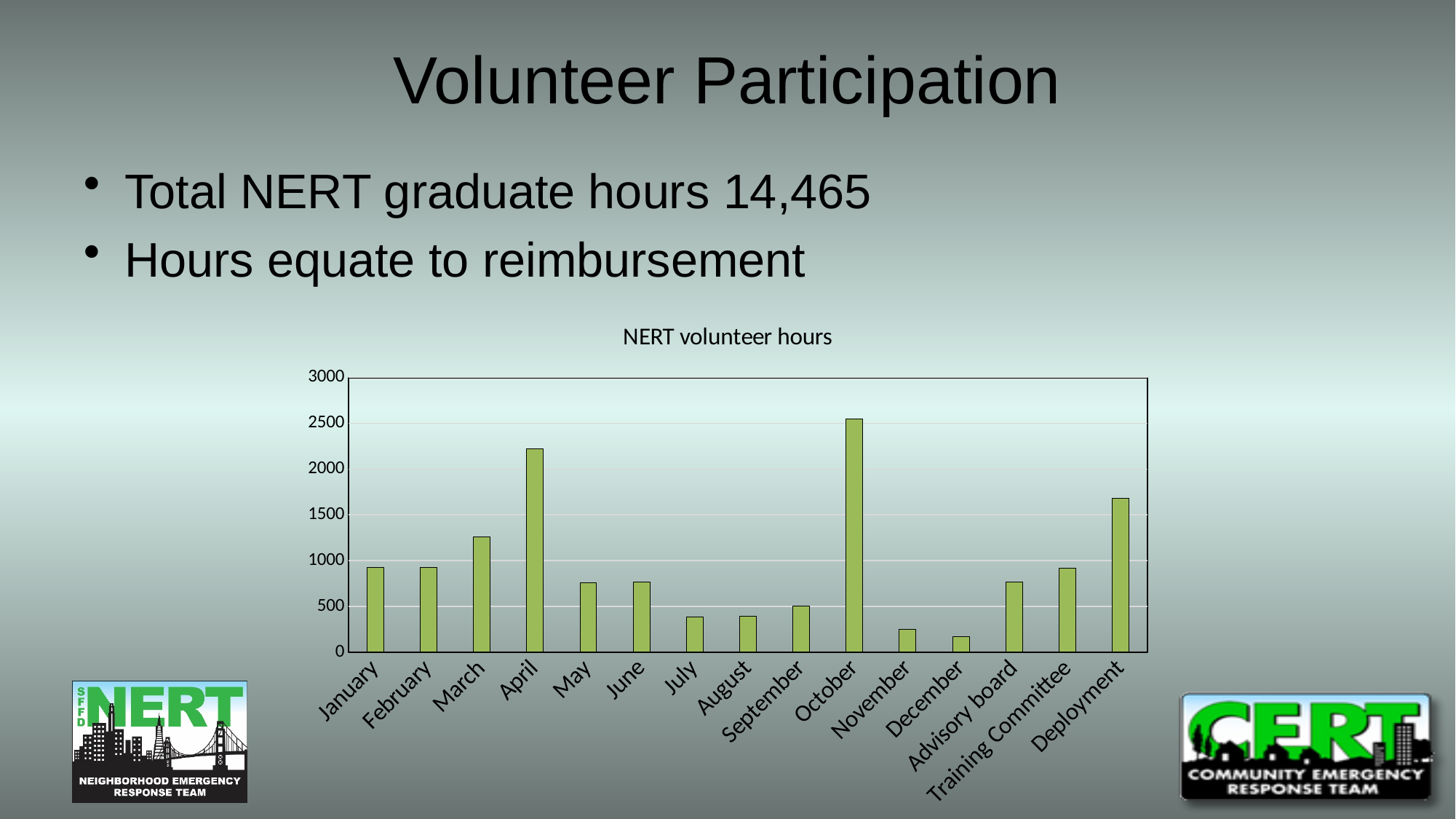
What is the title of the chart? NERT volunteer hours Which has more volunteer hours, April or Deployment? April How many categories are shown on the x axis of the chart? 15 What kind of chart is shown on the slide? bar chart Which category has the highest number of NERT volunteer hours? October Is the value for July greater or less than 500? less Which category has the lowest number of NERT volunteer hours? December Is the value for April greater or less than 2000? greater What colour are the bars in the chart? green Is the value for Deployment greater or less than 1500? greater Which has more volunteer hours, March or May? March